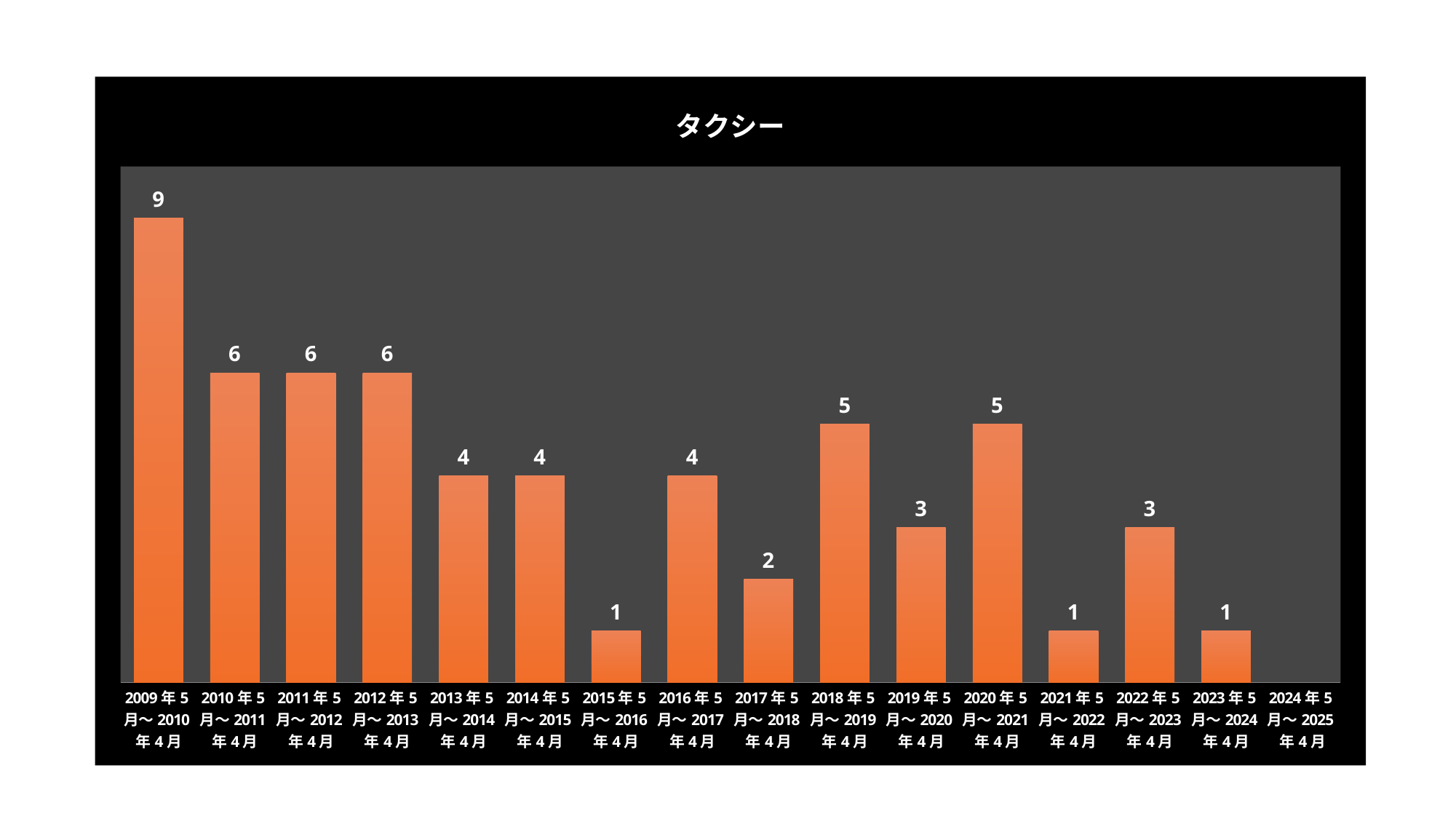
What type of chart is shown on the slide? bar chart What is the value for 2022年5月〜2023年4月? 3 Which period has the highest value? 2009年5月〜2010年4月 What is the difference between the values for 2009年5月〜2010年4月 and 2010年5月〜2011年4月? 3 What is the title of the chart? タクシー How many period categories are shown on the x axis? 16 What is the value for 2009年5月〜2010年4月? 9 What is the difference between the values for 2020年5月〜2021年4月 and 2021年5月〜2022年4月? 4 What is the value for 2017年5月〜2018年4月? 2 Which is larger, the value for 2018年5月〜2019年4月 or the value for 2019年5月〜2020年4月? 2018年5月〜2019年4月 What is the value for 2015年5月〜2016年4月? 1 Do the values generally rise or fall from 2009年5月〜2010年4月 to 2013年5月〜2014年4月? fall